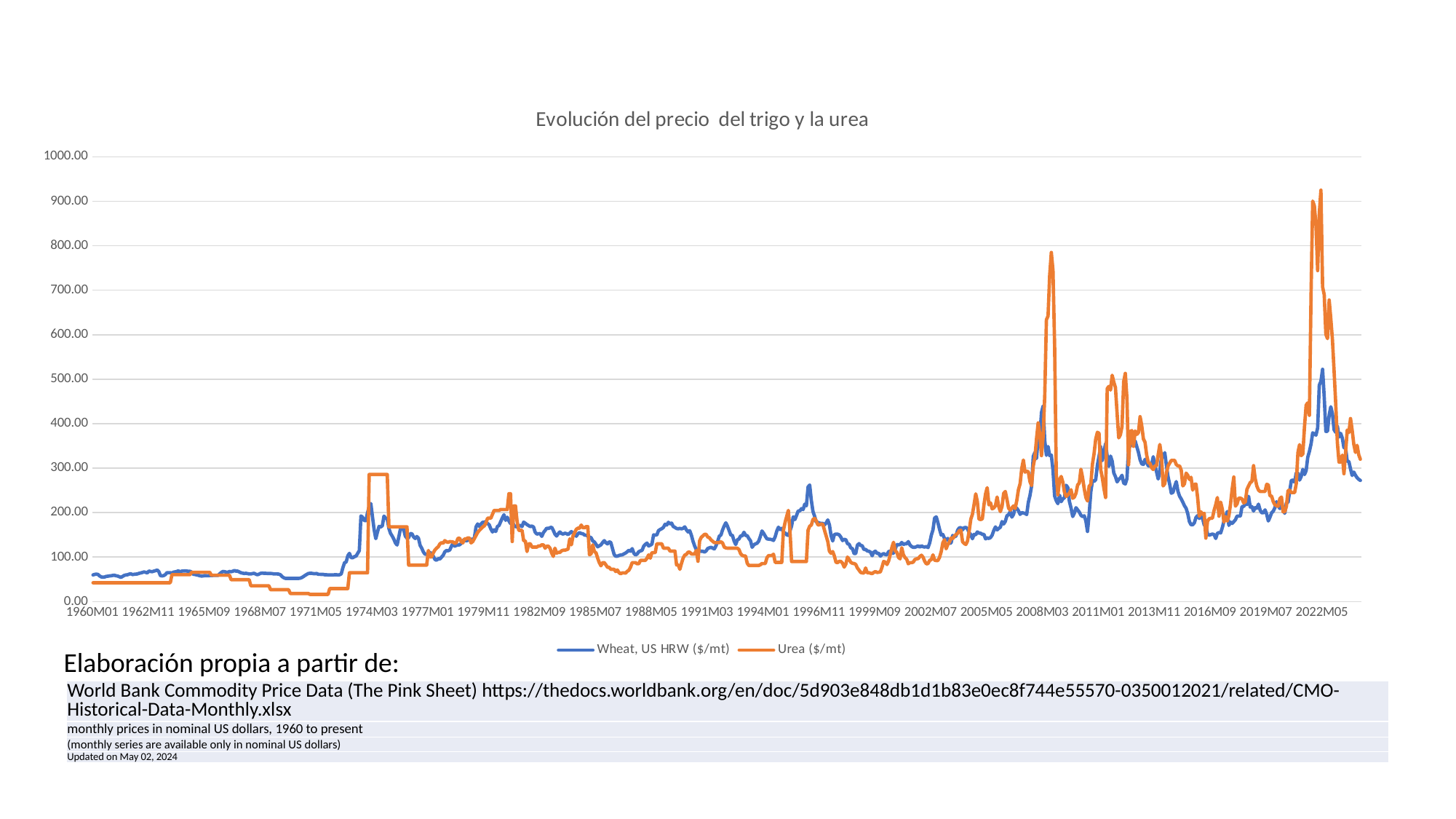
Around 2008M03, which series has the higher peak, Wheat, US HRW ($/mt) or Urea ($/mt)? Urea ($/mt) Is the value of Urea ($/mt) around 1971M05 greater or less than 100? less How many series does the legend list? 2 Is the highest value of the Urea ($/mt) series greater or less than 800? greater Overall, do the prices rise or fall from 1960M01 to 2022M05? rise What is the highest value shown on the y axis? 1000.00 What kind of chart is shown on the slide? line chart Which series reaches the highest value on the chart, Wheat, US HRW ($/mt) or Urea ($/mt)? Urea ($/mt) What is the title of the chart? Evolución del precio del trigo y la urea Is the highest value of the Wheat, US HRW ($/mt) series greater or less than 400? greater Which colour is used for the Urea ($/mt) series? orange